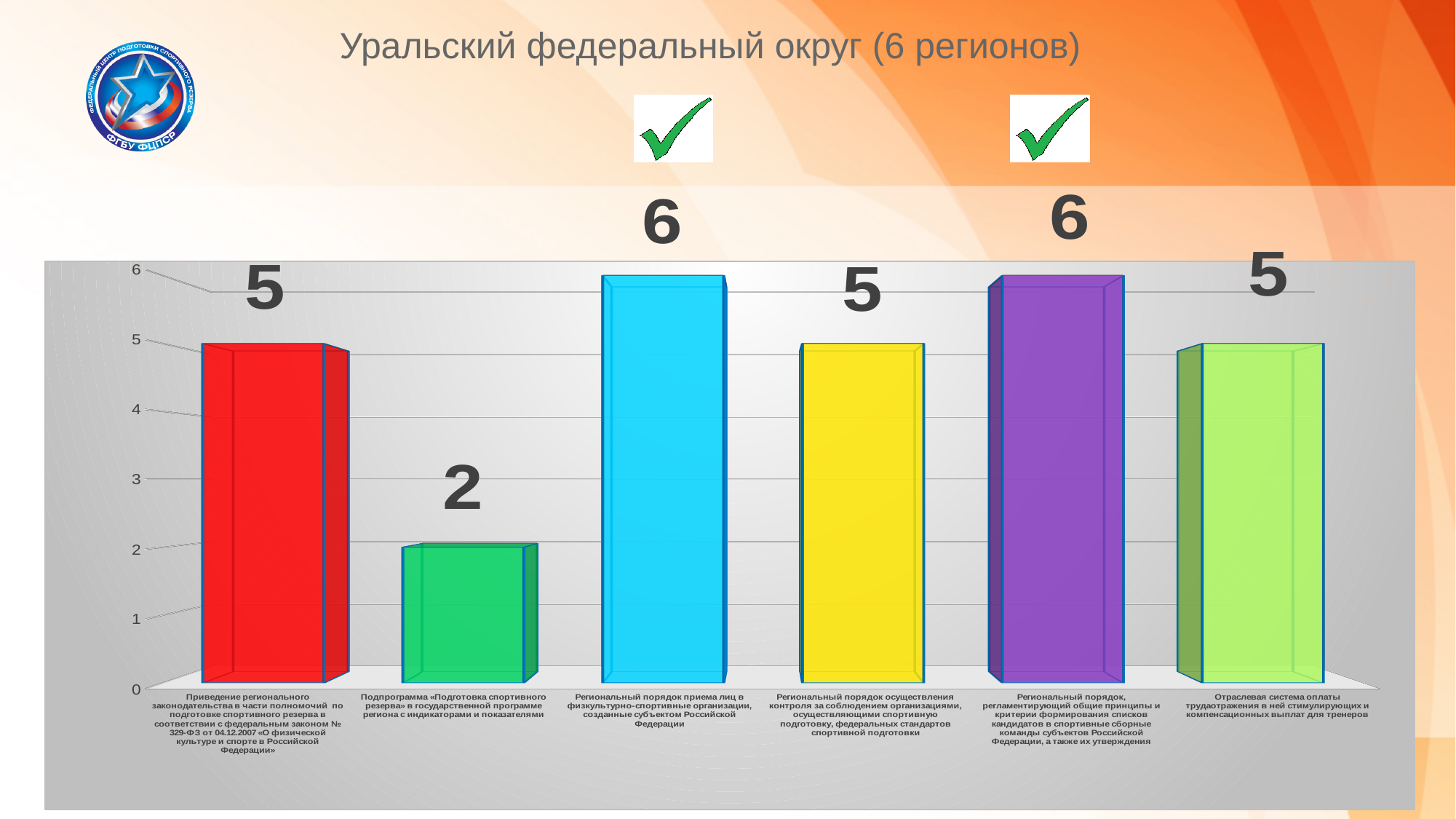
What is the title of the slide containing the chart? Уральский федеральный округ (6 регионов) What is the highest value shown in the chart? 6 Which is larger: the value for «Региональный порядок осуществления контроля за соблюдением организациями...» or the value for «Региональный порядок, регламентирующий общие принципы и критерии формирования списков кандидатов...»? Региональный порядок, регламентирующий общие принципы и критерии формирования списков кандидатов... What is the value of the bar for «Региональный порядок приема лиц в физкультурно-спортивные организации, созданные субъектом Российской Федерации»? 6 What is the value of the bar for «Отраслевая система оплаты труда, отражения в ней стимулирующих и компенсационных выплат для тренеров»? 5 What type of chart is shown on the slide? bar chart What is the value of the first (red) bar, «Приведение регионального законодательства в части полномочий по подготовке спортивного резерва...»? 5 Which category has the lowest value in the chart? Подпрограмма «Подготовка спортивного резерва» в государственной программе региона с индикаторами и показателями Is the value for «Подпрограмма «Подготовка спортивного резерва»...» greater or less than 3? less How many bars (categories) does the chart contain? 6 What is the difference between the value for «Региональный порядок приема лиц в физкультурно-спортивные организации...» and the value for «Подпрограмма «Подготовка спортивного резерва»...»? 4 What is the value of the bar for «Подпрограмма «Подготовка спортивного резерва» в государственной программе региона с индикаторами и показателями»? 2